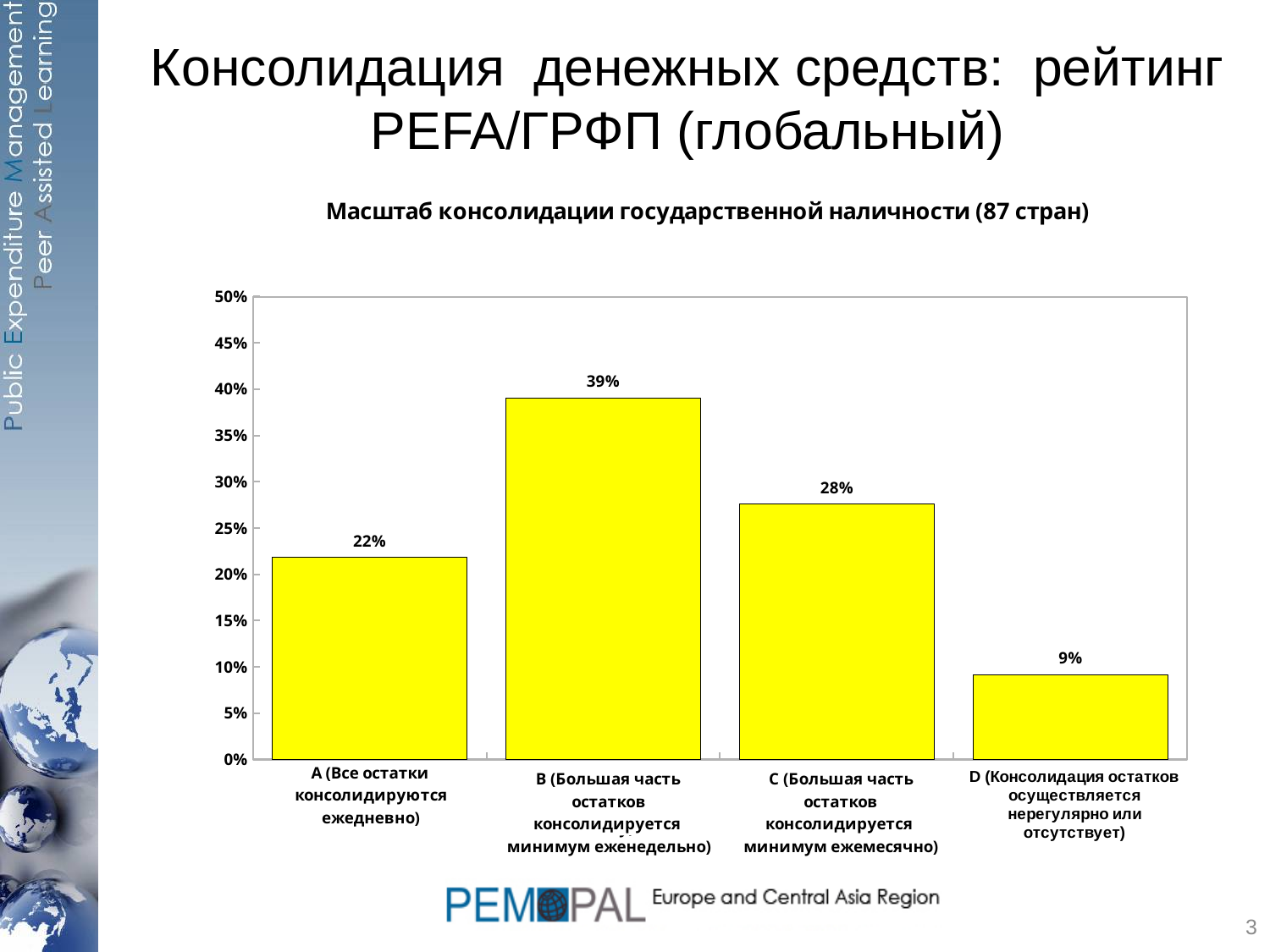
Which category has the lowest value? D (Консолидация остатков осуществляется нерегулярно или отсутствует) What is the value for category D (Консолидация остатков осуществляется нерегулярно или отсутствует)? 9% Which category has the highest value? B (Большая часть остатков консолидируется минимум еженедельно) What kind of chart is shown on the slide? bar chart What is the value for category A (Все остатки консолидируются ежедневно)? 22% Which is larger, the value for category A or the value for category C? C (Большая часть остатков консолидируется минимум ежемесячно) What is the title of the chart? Масштаб консолидации государственной наличности (87 стран) How many categories are shown in the chart? 4 What is the difference between the values for category B and category C? 11% What is the value for category C (Большая часть остатков консолидируется минимум ежемесячно)? 28% Is the value for category D greater or less than 10%? less What is the value for category B (Большая часть остатков консолидируется минимум еженедельно)? 39%